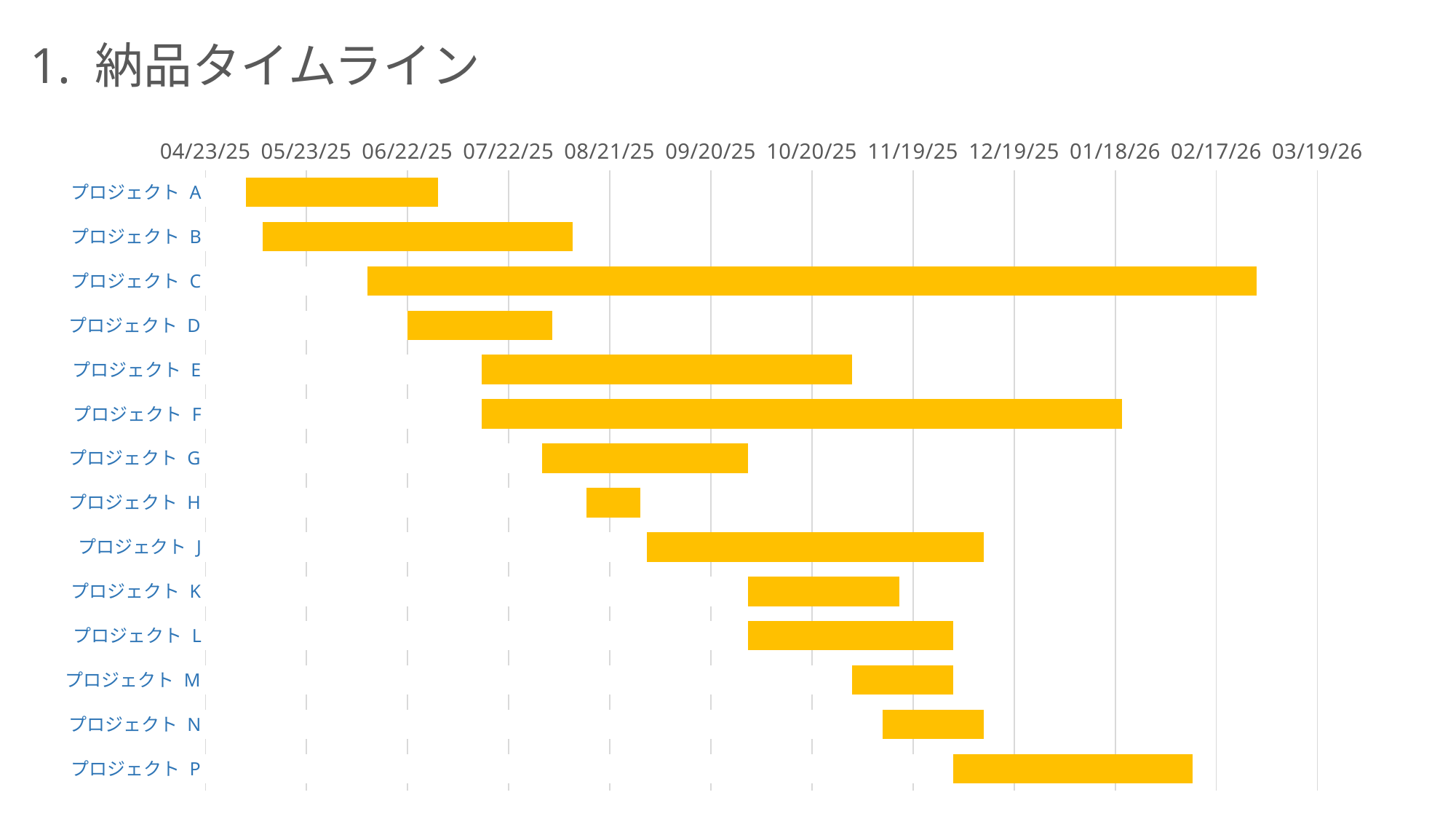
Which project has the shortest bar on the chart? プロジェクト H Does the bar for プロジェクト P start before or after 12/19/25? before Does the bar for プロジェクト A start before or after 05/23/25? before Which project's bar starts earliest on the timeline? プロジェクト A Which project's bar ends latest on the timeline? プロジェクト C Does the bar for プロジェクト J start before or after 08/21/25? after What kind of chart is shown on the slide? bar chart Which project's bar is longer, プロジェクト E or プロジェクト F? プロジェクト F What is the title of the slide containing the chart? 1. 納品タイムライン How many projects are listed on the chart? 14 Which project has the longest bar on the chart? プロジェクト C